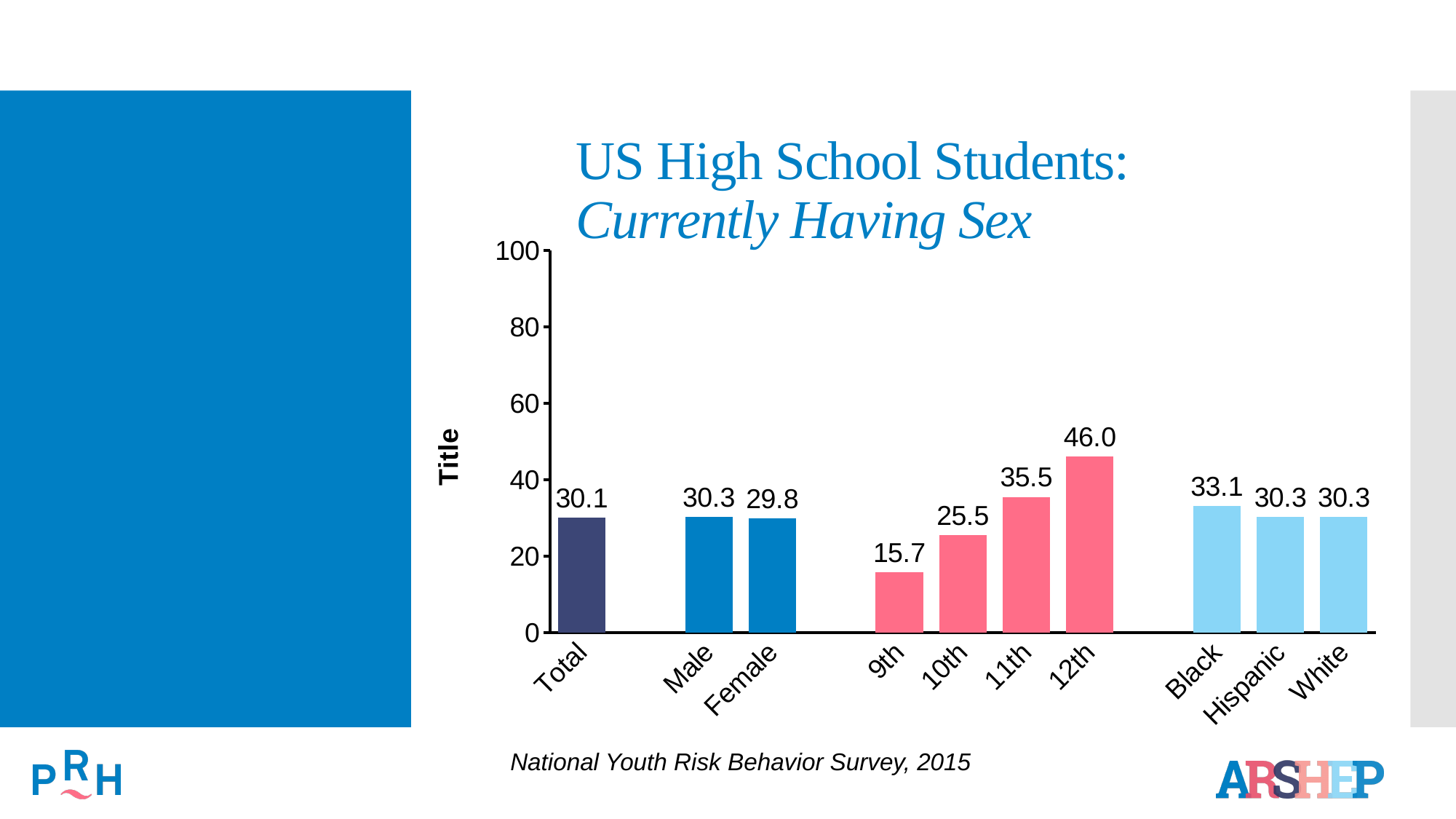
Is the value for 12th graders greater or less than 40? greater Which is larger, the value for 11th graders or the value for Black students? 11th What is the difference between the values for Male and Female? 0.5 Which category has the highest value? 12th What is the value for 12th graders? 46.0 What is the difference between the values for 12th and 9th graders? 30.3 What is the value for 9th graders? 15.7 How many bars are shown in the chart? 10 What is the value for the Total bar? 30.1 What is the value for Black students? 33.1 What kind of chart is shown on the slide? bar chart Which category has the lowest value? 9th